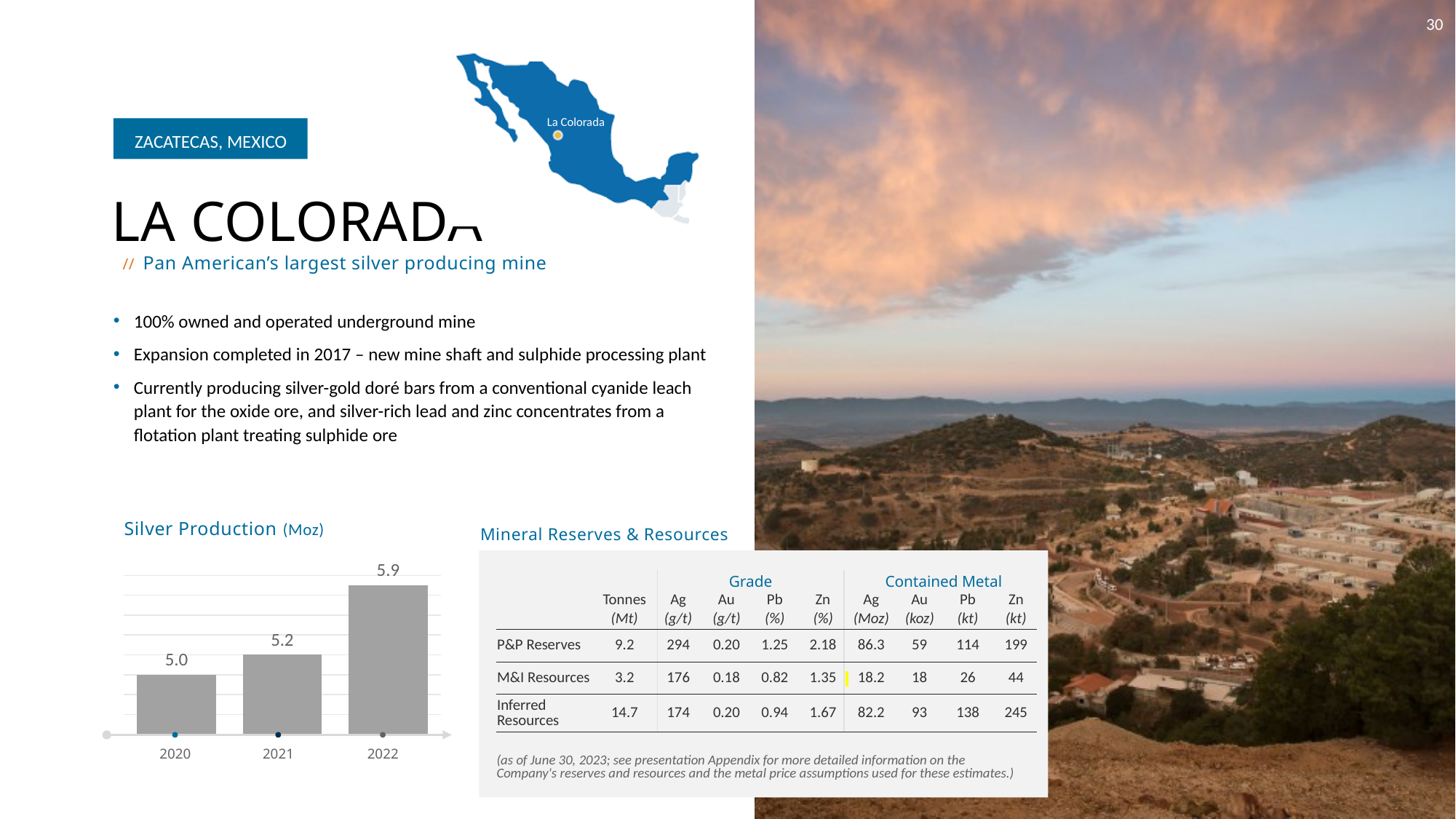
What unit is silver production measured in on the Silver Production chart? Moz In the Silver Production chart, is the value for 2021 larger than the value for 2020? Yes What was silver production in 2020 according to the Silver Production chart? 5.0 How many years are shown in the Silver Production chart? 3 What is the difference in silver production between 2020 and 2022 in the Silver Production chart? 0.9 What type of chart is the Silver Production chart? Bar chart By how much did silver production increase from 2021 to 2022 in the Silver Production chart? 0.7 Which year has the lowest silver production in the Silver Production chart? 2020 What was silver production in 2022 according to the Silver Production chart? 5.9 What was silver production in 2021 according to the Silver Production chart? 5.2 Which year has the highest silver production in the Silver Production chart? 2022 Does silver production rise or fall from 2020 to 2022 in the Silver Production chart? Rise